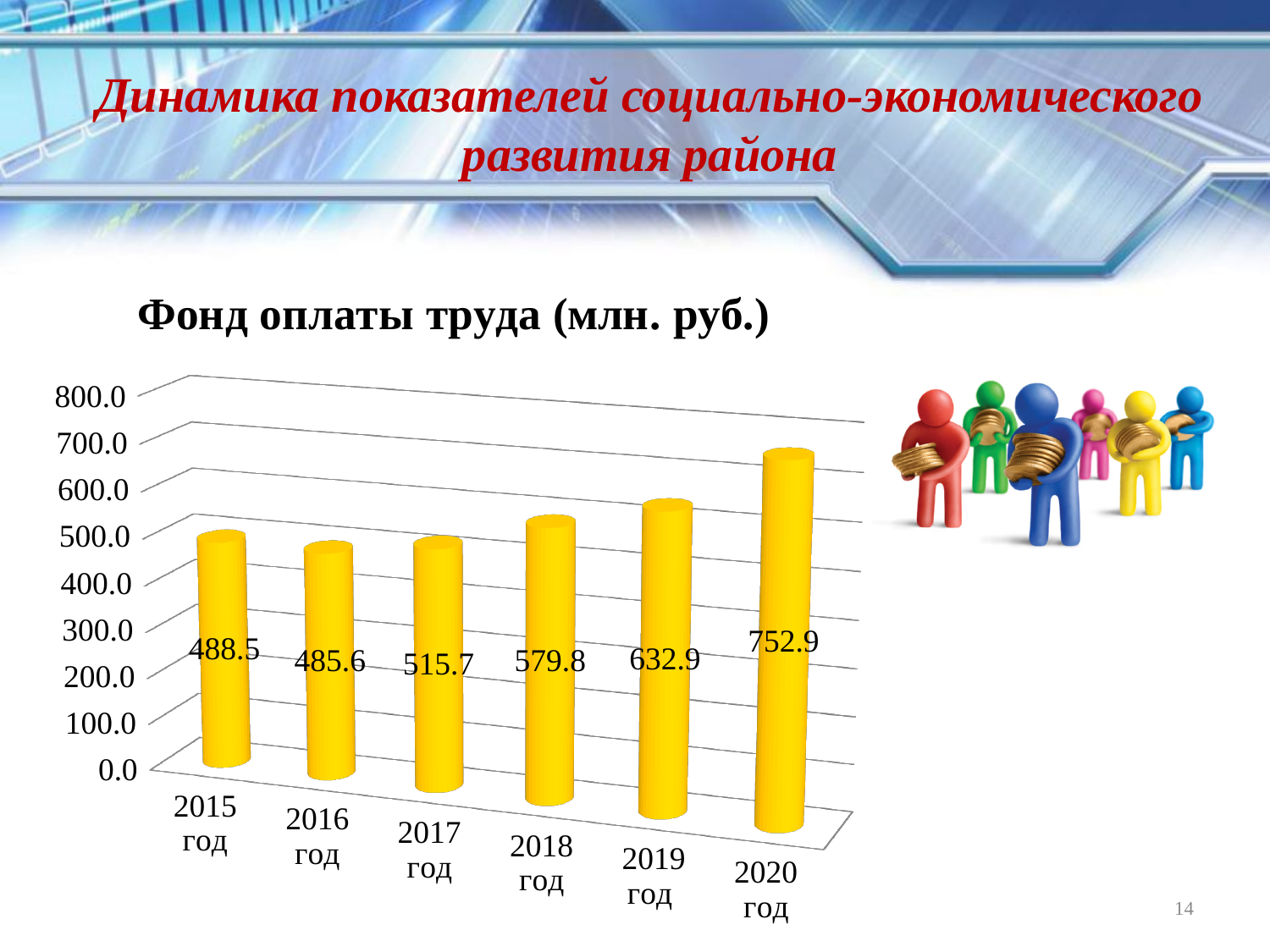
What is the value for 2020 год? 752.9 What is the difference between the values for 2018 год and 2017 год? 64.1 What kind of chart is shown? bar chart What is the value for 2018 год? 579.8 Which year has the lowest value? 2016 год Is the value for 2020 год greater or less than 700.0? greater How many years are shown on the chart? 6 Which is larger, the value for 2017 год or the value for 2019 год? 2019 год What is the title of the chart? Фонд оплаты труда (млн. руб.) Which year has the highest value? 2020 год What is the value for 2015 год? 488.5 What is the difference between the values for 2020 год and 2019 год? 120.0